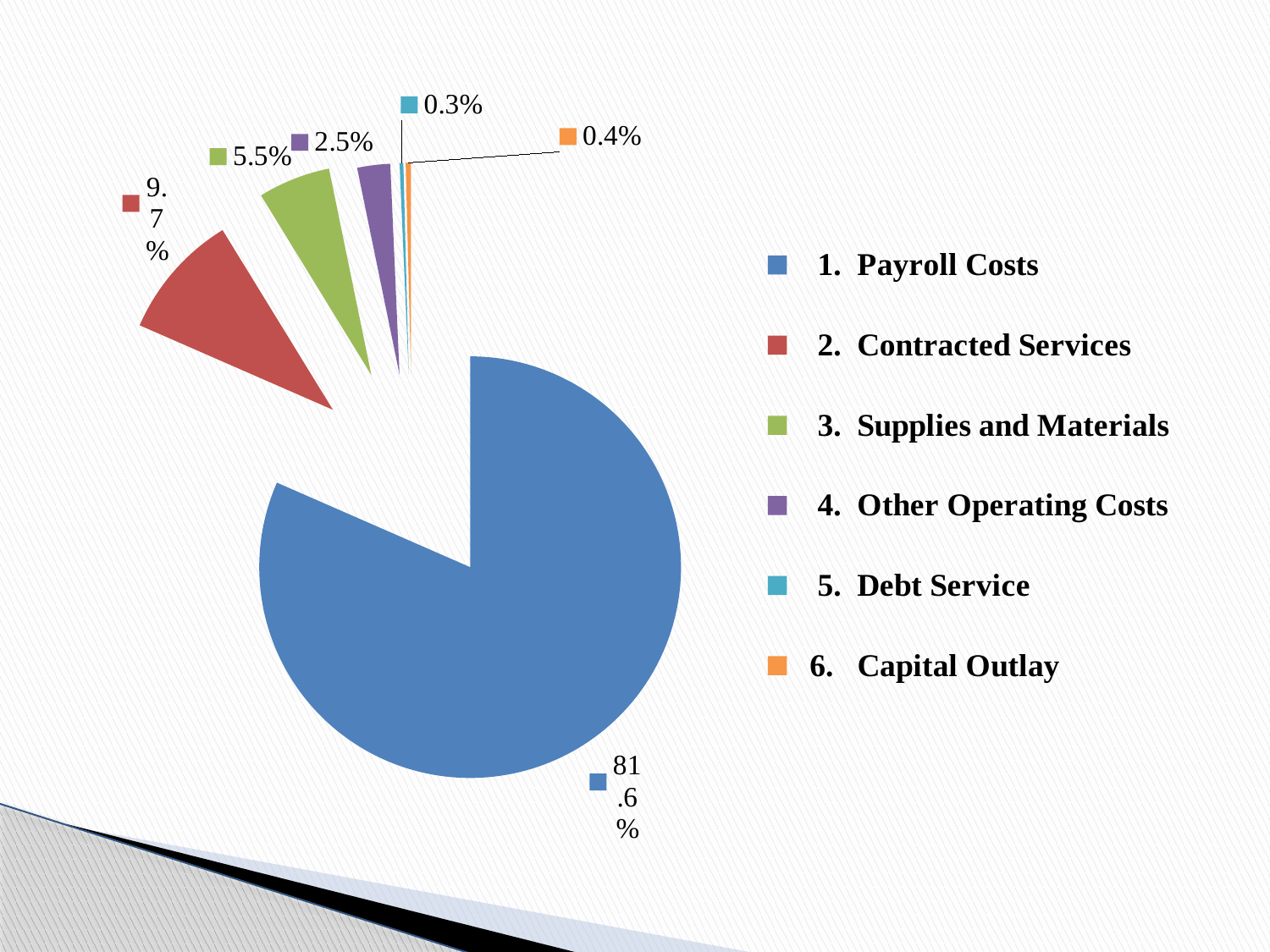
What share of the pie does Payroll Costs represent? 81.6% How many categories does the legend list? 6 What is the difference between the Contracted Services share and the Supplies and Materials share? 4.2% What share of the pie does Debt Service represent? 0.3% What share of the pie does Supplies and Materials represent? 5.5% Which category has the smallest slice of the pie? Debt Service Which is larger, the share for Capital Outlay or the share for Debt Service? Capital Outlay What share of the pie does Other Operating Costs represent? 2.5% What share of the pie does Contracted Services represent? 9.7% What share of the pie does Capital Outlay represent? 0.4% Which category has the largest slice of the pie? Payroll Costs What kind of chart is shown on the slide? pie chart